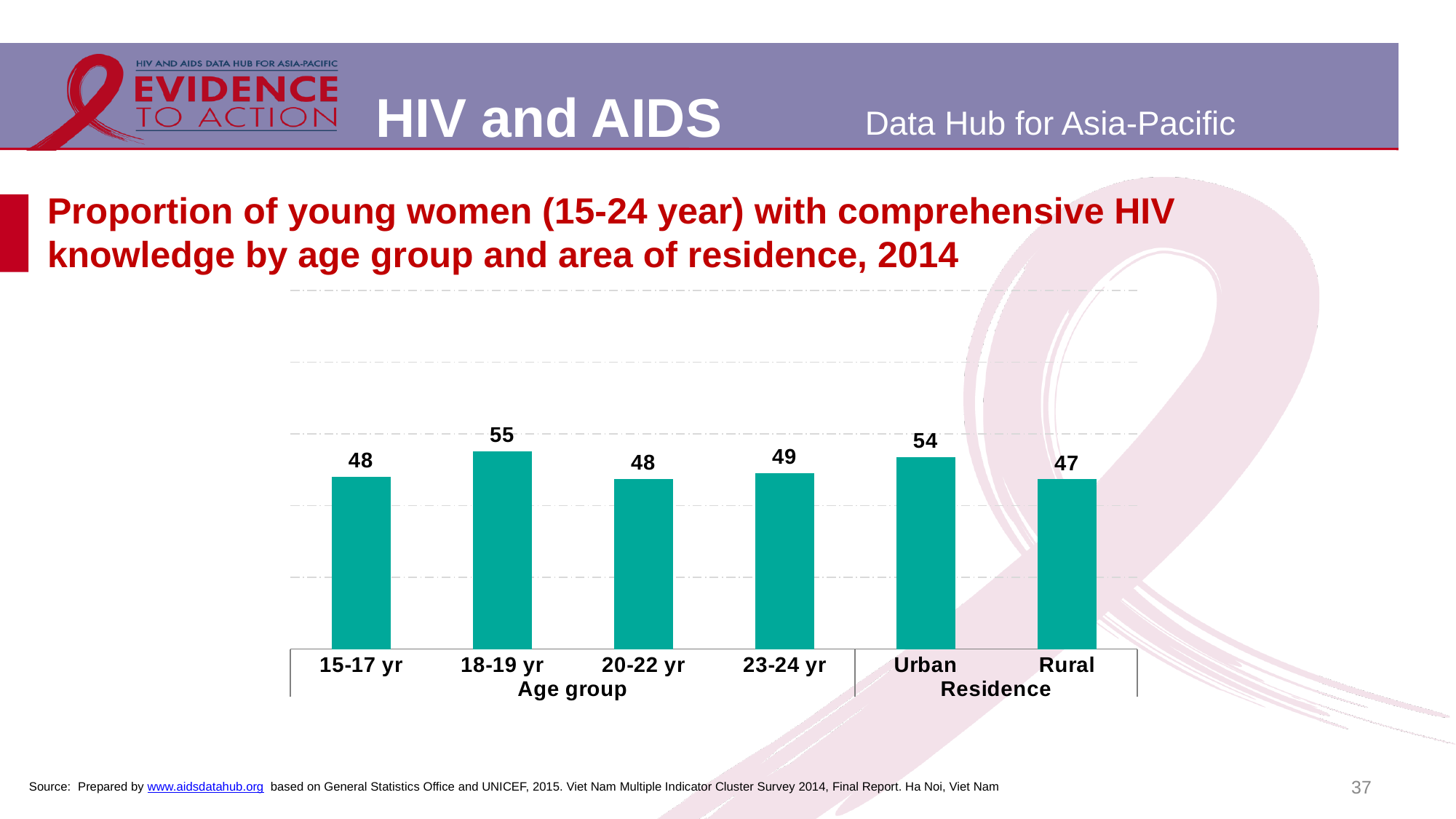
What is the value for the 18-19 yr age group? 55 How many bars are shown in the chart? 6 What is the value for the 15-17 yr age group? 48 What are the two group labels shown beneath the category axis? Age group and Residence Which category has the highest value? 18-19 yr What is the difference between the Urban and Rural values? 7 Which is larger, the value for 23-24 yr or the value for 20-22 yr? 23-24 yr What is the difference between the 18-19 yr and 20-22 yr values? 7 Which category has the lowest value? Rural What is the value for Rural residence? 47 What is the value for Urban residence? 54 What kind of chart is shown on the slide? Bar chart